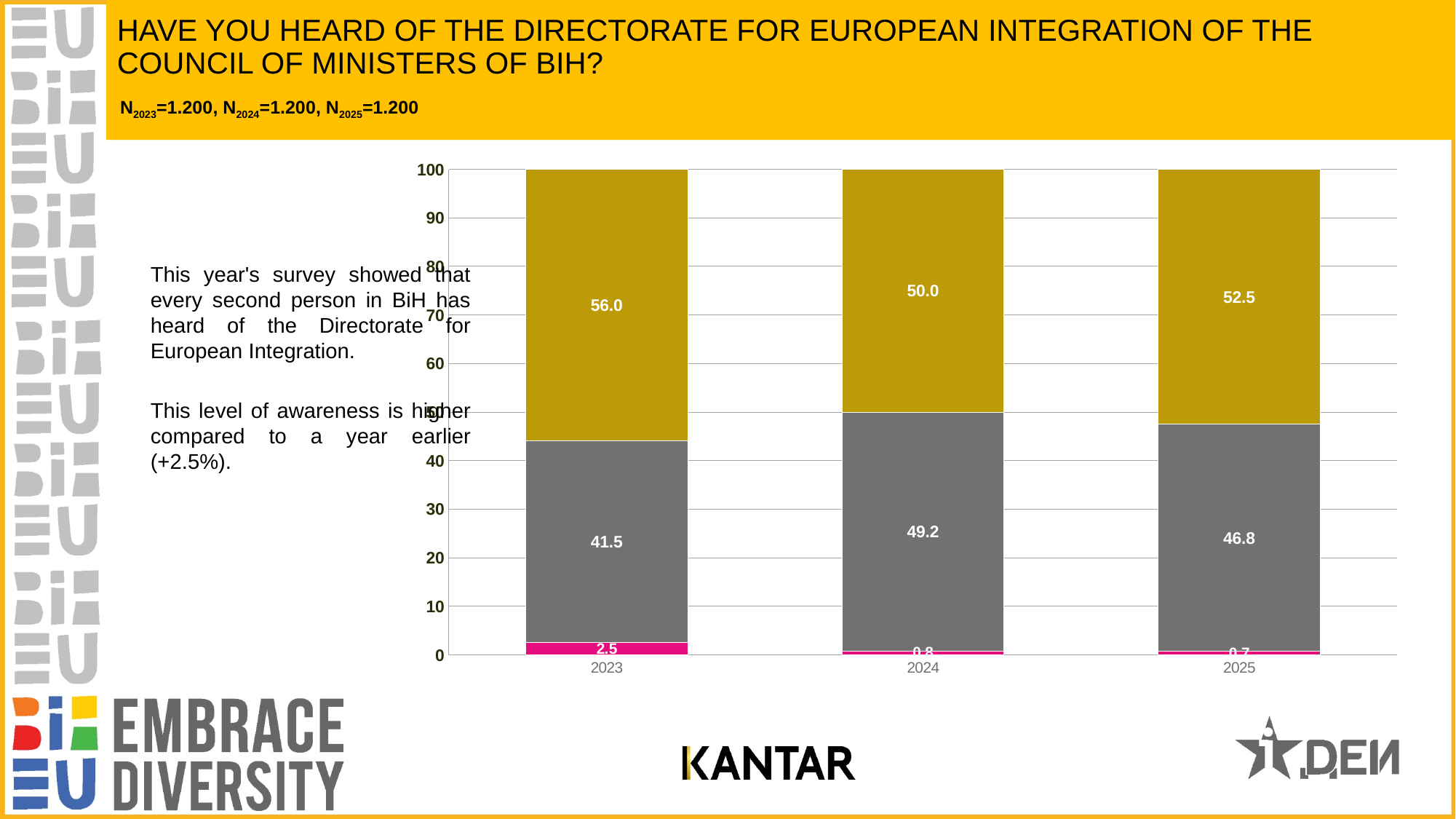
In which year is the gold (top) segment the largest? 2023 How does the grey (middle) segment change from 2023 to 2024? It rises What is the value of the gold (top) segment for 2023? 56.0 In which year is the pink (bottom) segment the smallest? 2025 What is the value of the grey (middle) segment for 2024? 49.2 What is the value of the pink (bottom) segment for 2025? 0.7 What is the value of the grey (middle) segment for 2025? 46.8 What type of chart is shown on the slide? Stacked bar chart What is the difference between the gold segment values for 2025 and 2024? 2.5 What is the total of the stacked bar for 2023? 100.0 Which is larger: the grey segment for 2024 or the grey segment for 2023? 2024 How many years (categories) are shown on the x axis of the chart? 3